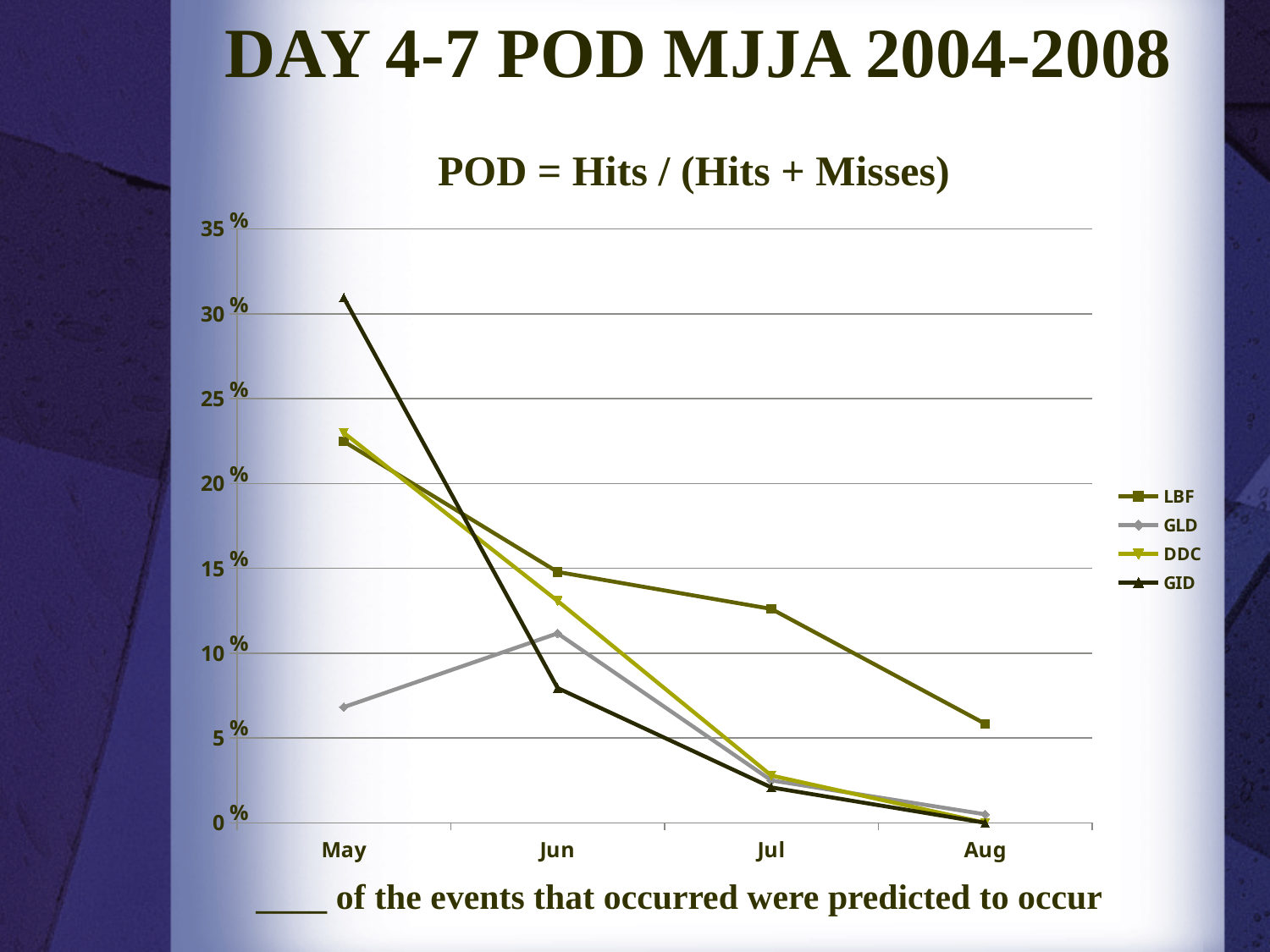
What kind of chart is shown on the slide? line chart How many months are shown along the x axis? 4 Which is larger in Jun, the value for LBF or the value for GID? LBF Is the value for GID in May greater or less than 30%? greater Does the GLD series rise or fall from May to Jun? rise Which series has the highest value in May? GID Is the value for GLD in May greater or less than 10%? less Is the value for LBF in Jul greater or less than 10%? greater Which series has the lowest value in May? GLD Does the LBF series rise or fall from May to Aug? fall Which series has the highest value in Aug? LBF How many series does the legend list? 4